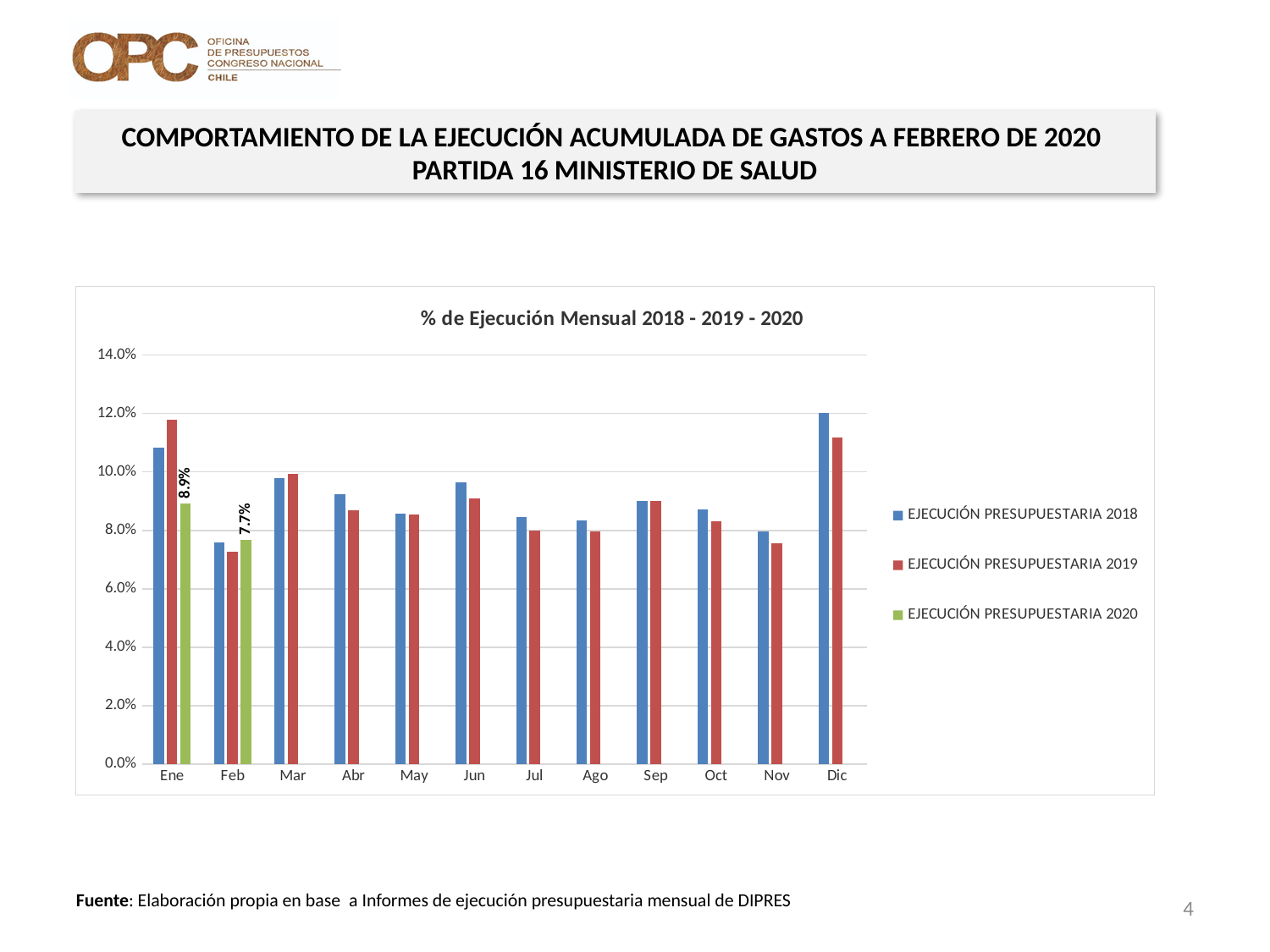
In Ene, which series has the larger value: EJECUCIÓN PRESUPUESTARIA 2018 or EJECUCIÓN PRESUPUESTARIA 2019? EJECUCIÓN PRESUPUESTARIA 2019 Which month has the highest value for EJECUCIÓN PRESUPUESTARIA 2018? Dic What kind of chart is shown on the slide? Bar chart What is the title of the chart? % de Ejecución Mensual 2018 - 2019 - 2020 Is the value for EJECUCIÓN PRESUPUESTARIA 2019 in Feb greater or less than 8.0%? less How many months are shown on the x axis of the chart? 12 How many series does the legend list? 3 Is the value for EJECUCIÓN PRESUPUESTARIA 2018 in Dic greater or less than 10.0%? greater Which month has the highest value for EJECUCIÓN PRESUPUESTARIA 2019? Ene What is the difference between the EJECUCIÓN PRESUPUESTARIA 2020 values for Ene and Feb? 1.2% What is the value of EJECUCIÓN PRESUPUESTARIA 2020 for Ene? 8.9% What is the value of EJECUCIÓN PRESUPUESTARIA 2020 for Feb? 7.7%